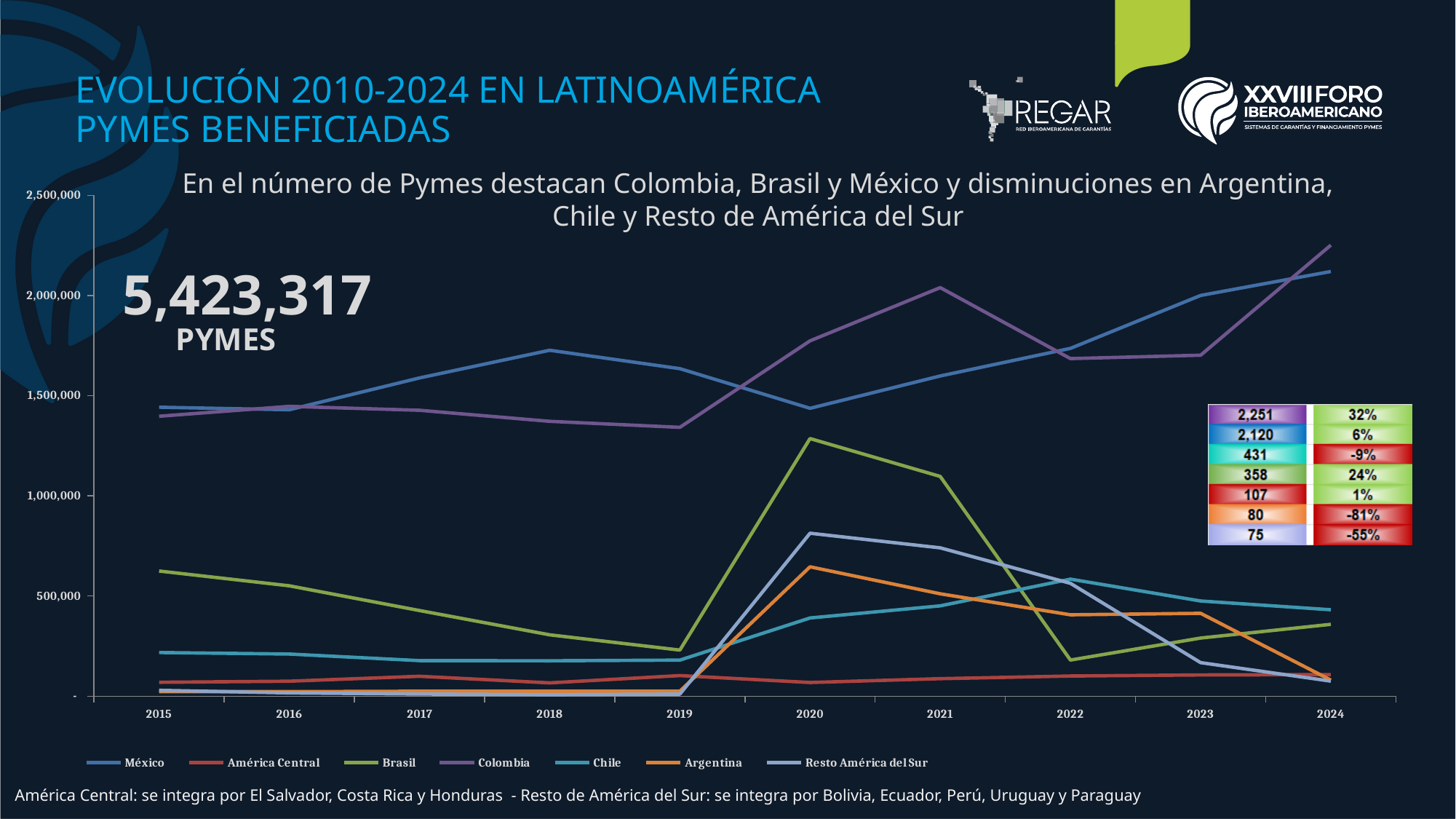
Does the Brasil line rise or fall from 2015 to 2019? fall Is the value for Argentina in 2020 greater or less than 500,000? greater In 2021, which is larger: Colombia or México? Colombia How many series does the legend list? 7 Is the value for Brasil in 2020 greater or less than 1,000,000? greater Is the value for Colombia in 2019 greater or less than 1,500,000? less What total number of PYMES is printed in large text on the slide? 5,423,317 Which series has the highest value in 2015? México Which series has the highest value in 2024? Colombia What kind of chart is shown on the slide? line chart How many years are shown on the x axis? 10